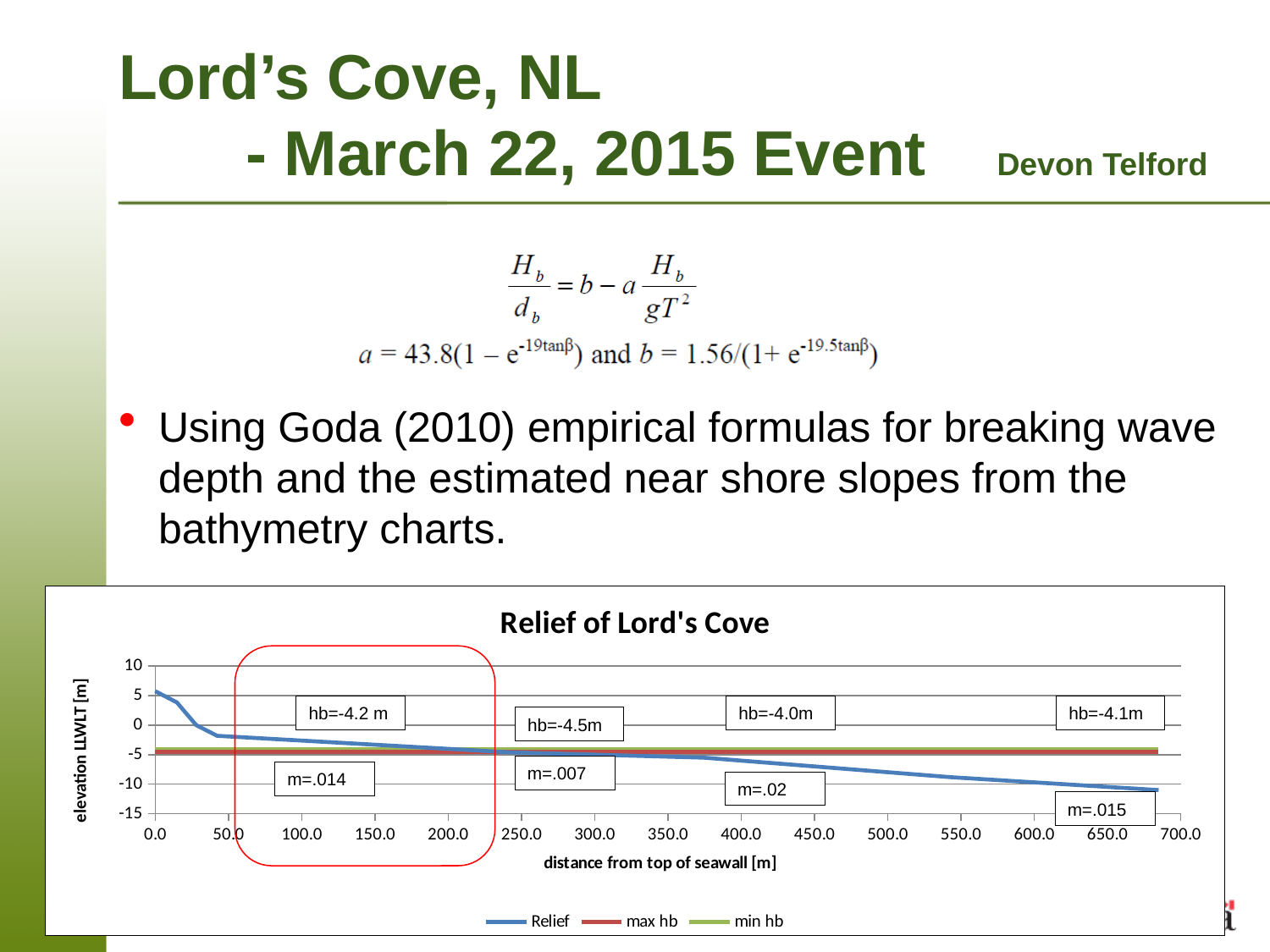
How many series does the chart legend list? 3 What are the three series named in the chart legend? Relief, max hb, min hb What is the title of the chart? Relief of Lord's Cove Is the max hb line greater or less than 0 on the elevation axis? less Does the Relief line rise or fall as the distance from the top of the seawall increases? fall What hb value is annotated in the section of the chart enclosed by the red rounded box? hb=-4.2 m What hb value is annotated at the far right of the chart, near 650.0 m? hb=-4.1m What slope value m is annotated near the 400.0 to 450.0 m distance range? m=.02 Is the Relief value at a distance of 0.0 m greater or less than 0? greater Is the Relief value at a distance of 650.0 m greater or less than -5? less How many hb annotation boxes are shown on the chart? 4 What type of chart is shown on the slide? line chart